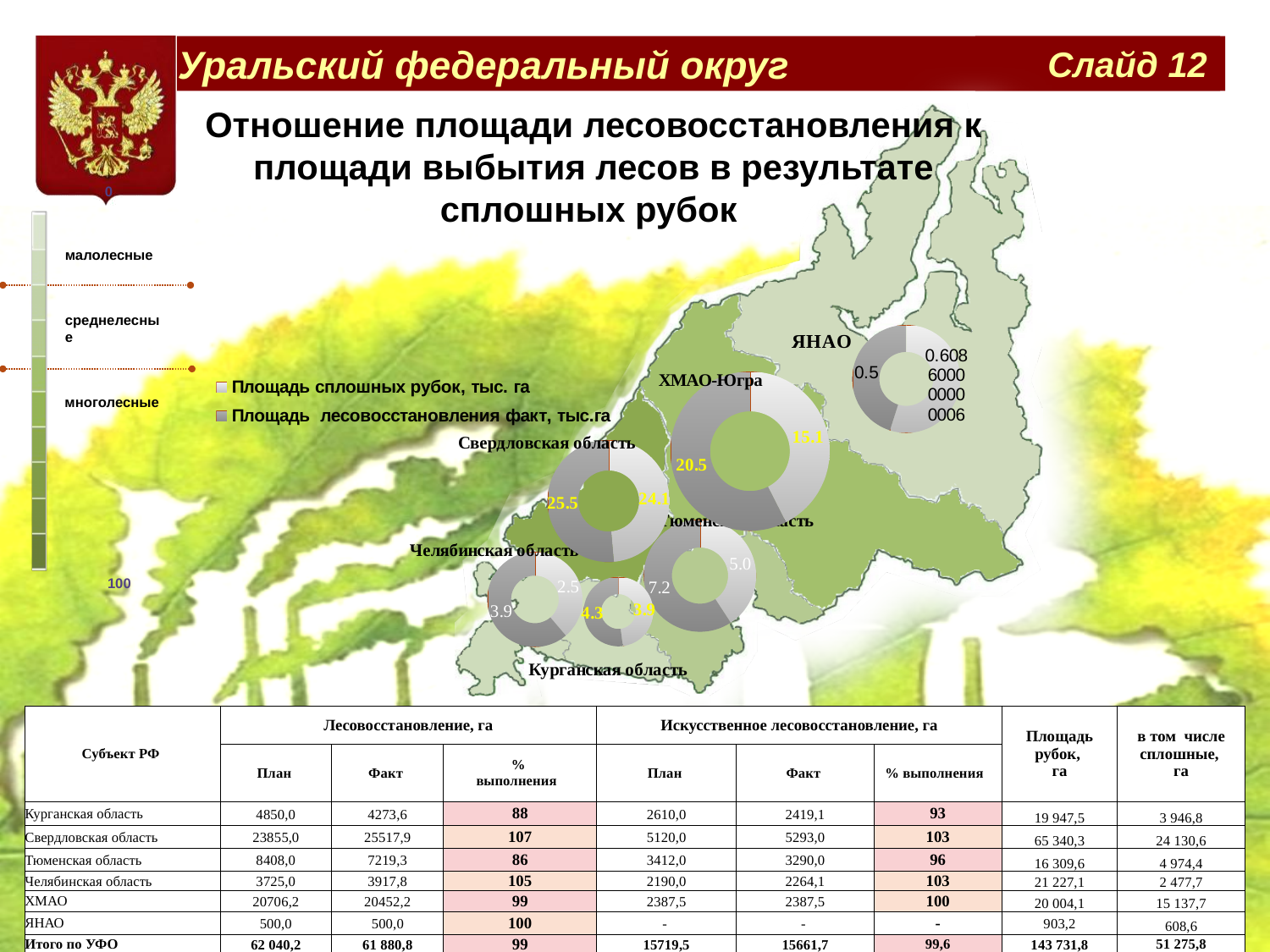
What is the difference between the two values shown in the ХМАО-Югра doughnut chart? 5.4 In the Челябинская область doughnut chart, what is the smaller of the two values shown? 2.5 In the Курганская область doughnut chart, what is the larger of the two values shown? 4.3 How many series does the chart legend list? 2 What is the first entry in the chart legend? Площадь сплошных рубок, тыс. га In the ХМАО-Югра doughnut chart, what is the larger of the two values shown? 20.5 What kind of chart is used for each region on the map? doughnut chart What is the second entry in the chart legend? Площадь лесовосстановления факт, тыс.га In the ХМАО-Югра doughnut chart, what is the smaller of the two values shown? 15.1 In the Свердловская область doughnut chart, what is the larger of the two values shown? 25.5 How many regional doughnut charts are placed on the map? 6 In the Тюменская область doughnut chart, what is the larger of the two values shown? 7.2